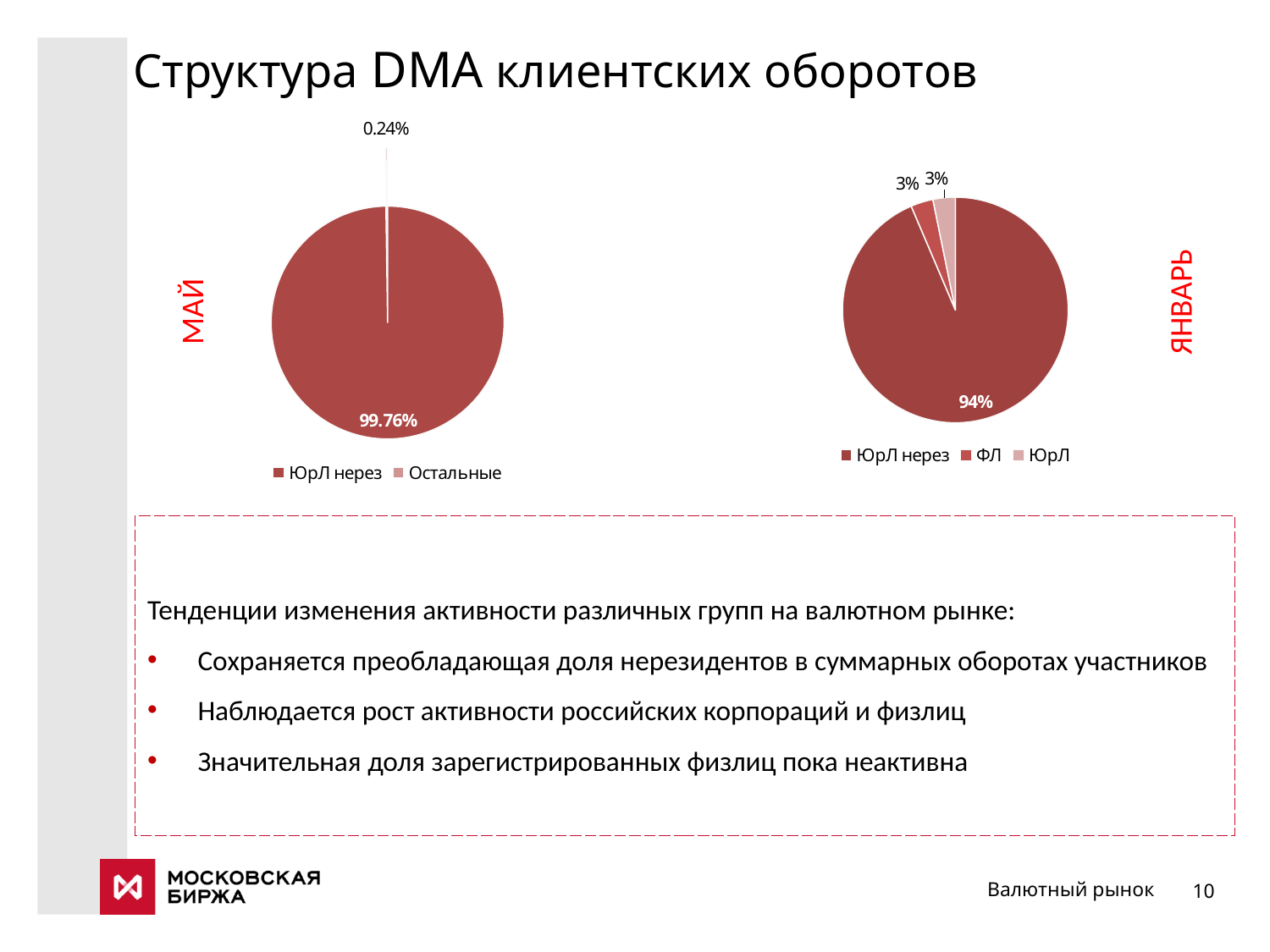
Which is larger: the ЮрЛ нерез share in the left chart (МАЙ) or in the right chart (ЯНВАРЬ)? МАЙ What is the difference between the ЮрЛ нерез share in the left chart (МАЙ) and in the right chart (ЯНВАРЬ)? 5.76% In the left chart (МАЙ), which category has the smallest slice? Остальные How many series does the legend of the left chart (МАЙ) list? 2 In the right chart (ЯНВАРЬ), which category has the largest slice? ЮрЛ нерез In the right chart (ЯНВАРЬ), what share does ФЛ have? 3% In the right chart (ЯНВАРЬ), what share does ЮрЛ нерез have? 94% In the left chart (МАЙ), what share does ЮрЛ нерез have? 99.76% How many series does the legend of the right chart (ЯНВАРЬ) list? 3 What kind of chart is the left chart labelled МАЙ? pie chart What is the title of the slide containing the two pie charts? Структура DMA клиентских оборотов